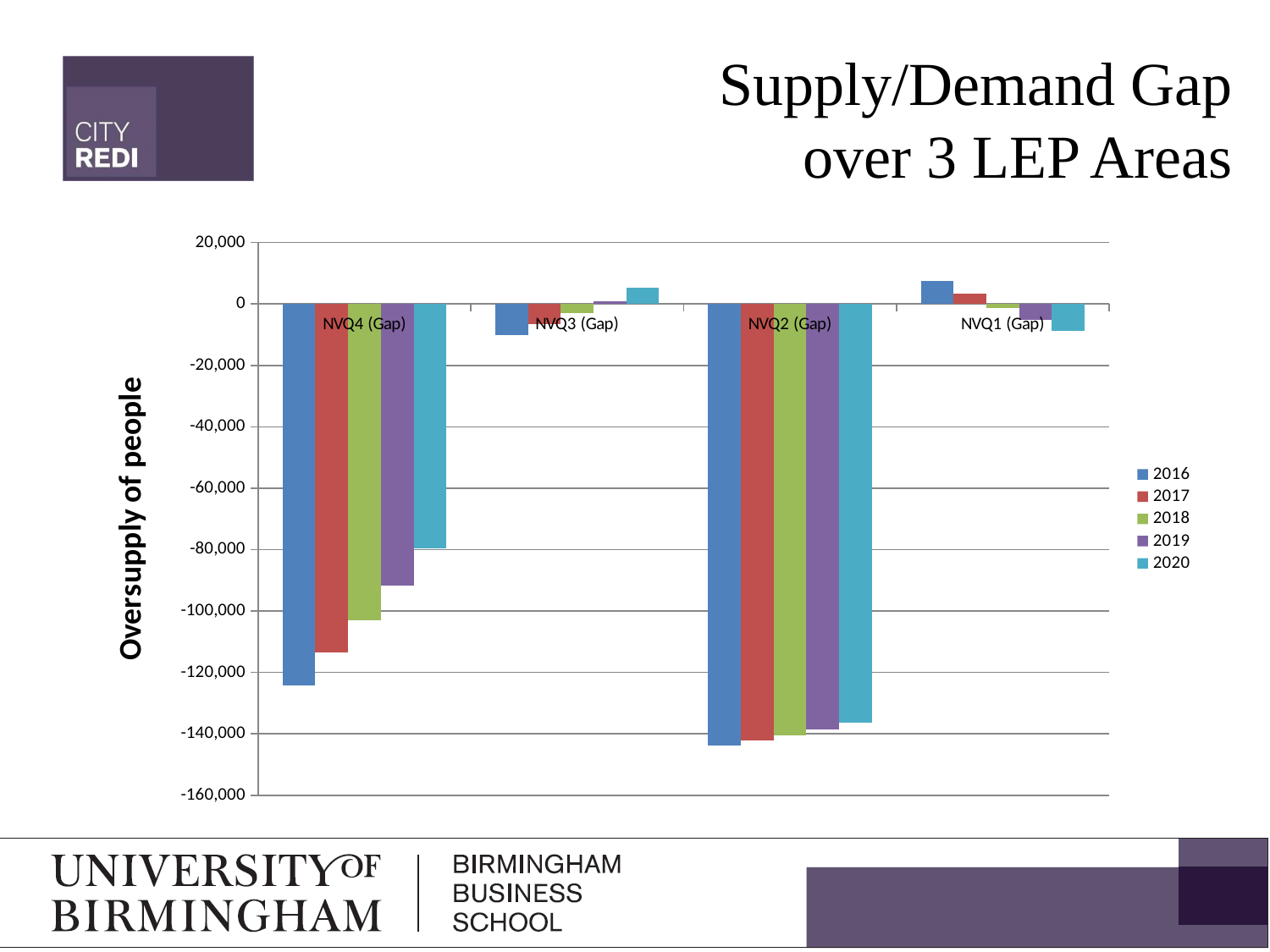
Is the 2020 value for NVQ2 (Gap) greater or less than -120,000? less What is the title of the vertical axis? Oversupply of people Which category has the highest value for the 2016 series? NVQ1 (Gap) How many series does the legend list? 5 Is the 2019 value for NVQ4 (Gap) greater or less than -100,000? greater What kind of chart is shown on the slide? bar chart Is the 2016 value for NVQ2 (Gap) greater or less than -140,000? less Which category has the lowest value for the 2016 series? NVQ2 (Gap) For NVQ4 (Gap), which is larger: the 2016 value or the 2020 value? 2020 How many categories are shown on the x axis of the chart? 4 For NVQ4 (Gap), do the values rise or fall from 2016 to 2020? rise